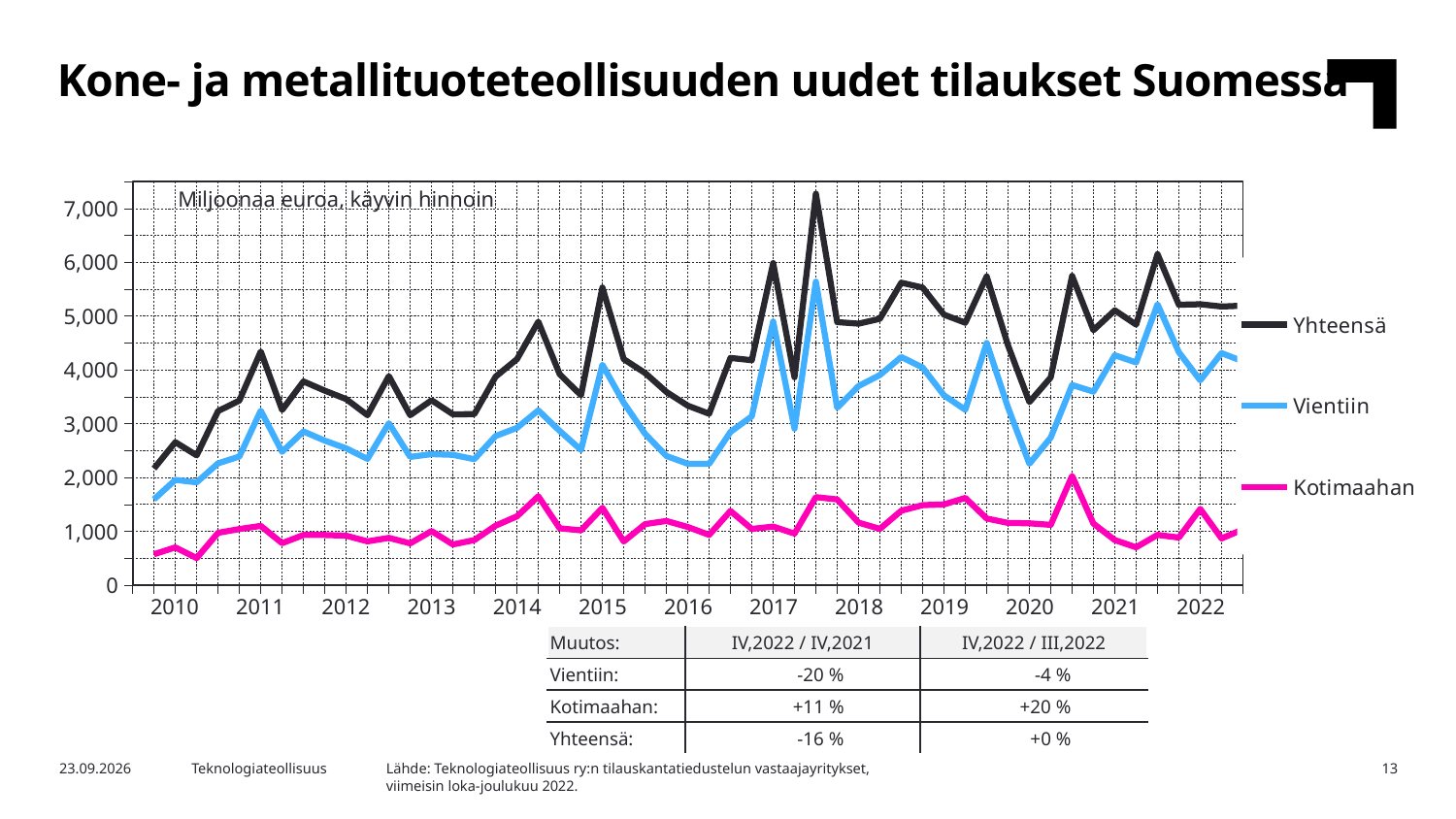
Is the value of the Yhteensä line at the start of 2010 greater or less than 2,000? greater Is the Kotimaahan line ever greater than 3,000 at any point? No What are the three series named in the legend? Yhteensä, Vientiin, Kotimaahan Which series has the lowest values throughout the chart? Kotimaahan What is the title of the chart on the slide? Kone- ja metallituoteteollisuuden uudet tilaukset Suomessa How many series does the legend list? 3 Is the value of the Vientiin line at the start of 2010 greater or less than 2,000? less Which is larger throughout the chart, the Vientiin line or the Kotimaahan line? Vientiin Does the Yhteensä line overall rise or fall from 2010 to 2022? rise How many years are labelled on the x axis? 13 What type of chart is shown on the slide? line chart